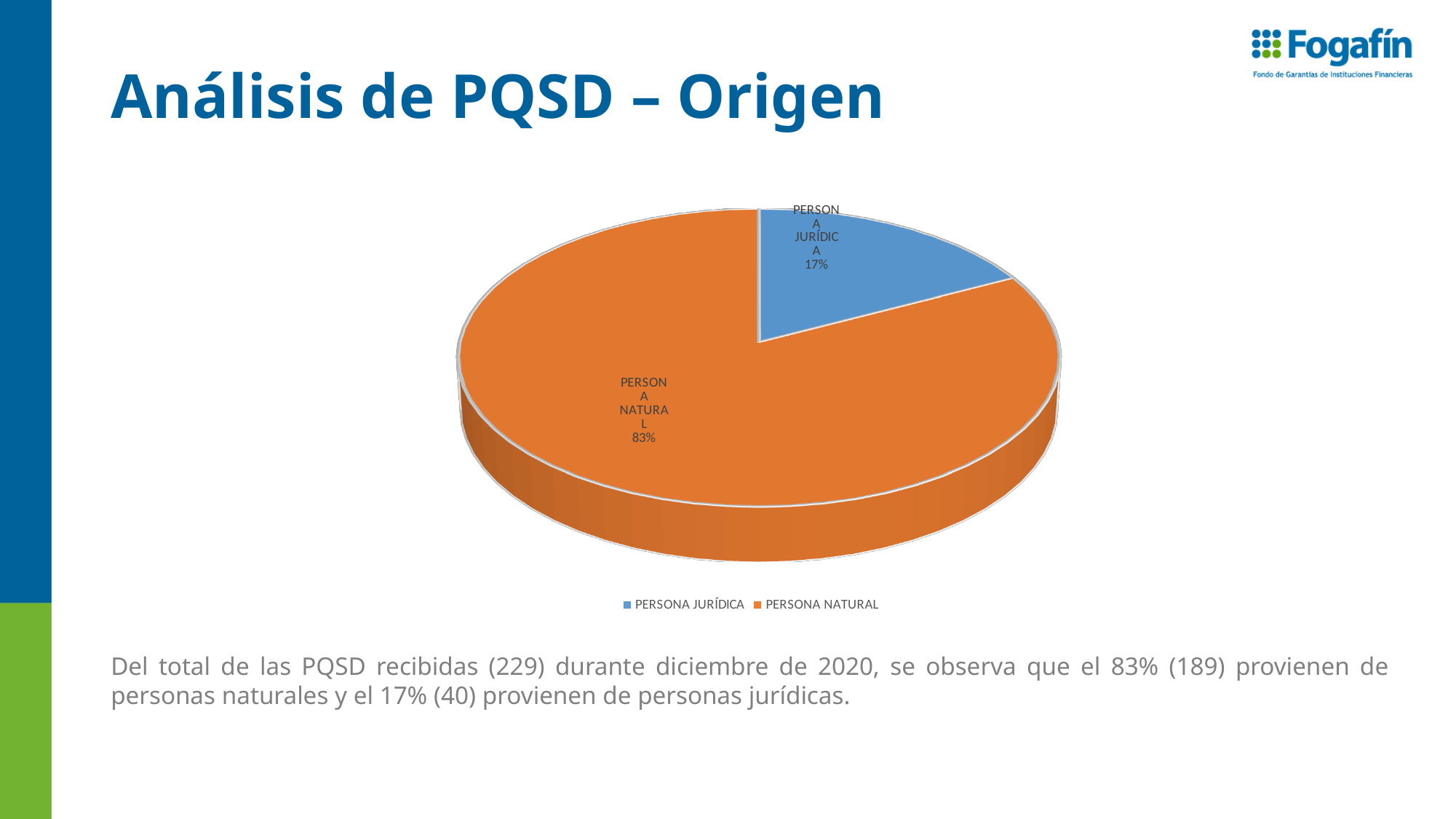
What kind of chart is shown on the slide? Pie chart Which category has the smallest slice of the pie? PERSONA JURÍDICA How many entries does the legend list? 2 What colour is the PERSONA JURÍDICA slice? Blue What colour is the PERSONA NATURAL slice? Orange Which slice is larger, PERSONA JURÍDICA or PERSONA NATURAL? PERSONA NATURAL What share of the pie does PERSONA JURÍDICA represent? 17% What share of the pie does PERSONA NATURAL represent? 83% How many categories does the pie chart show? 2 What is the difference in percentage points between the PERSONA NATURAL and PERSONA JURÍDICA slices? 66 Which category has the largest slice of the pie? PERSONA NATURAL